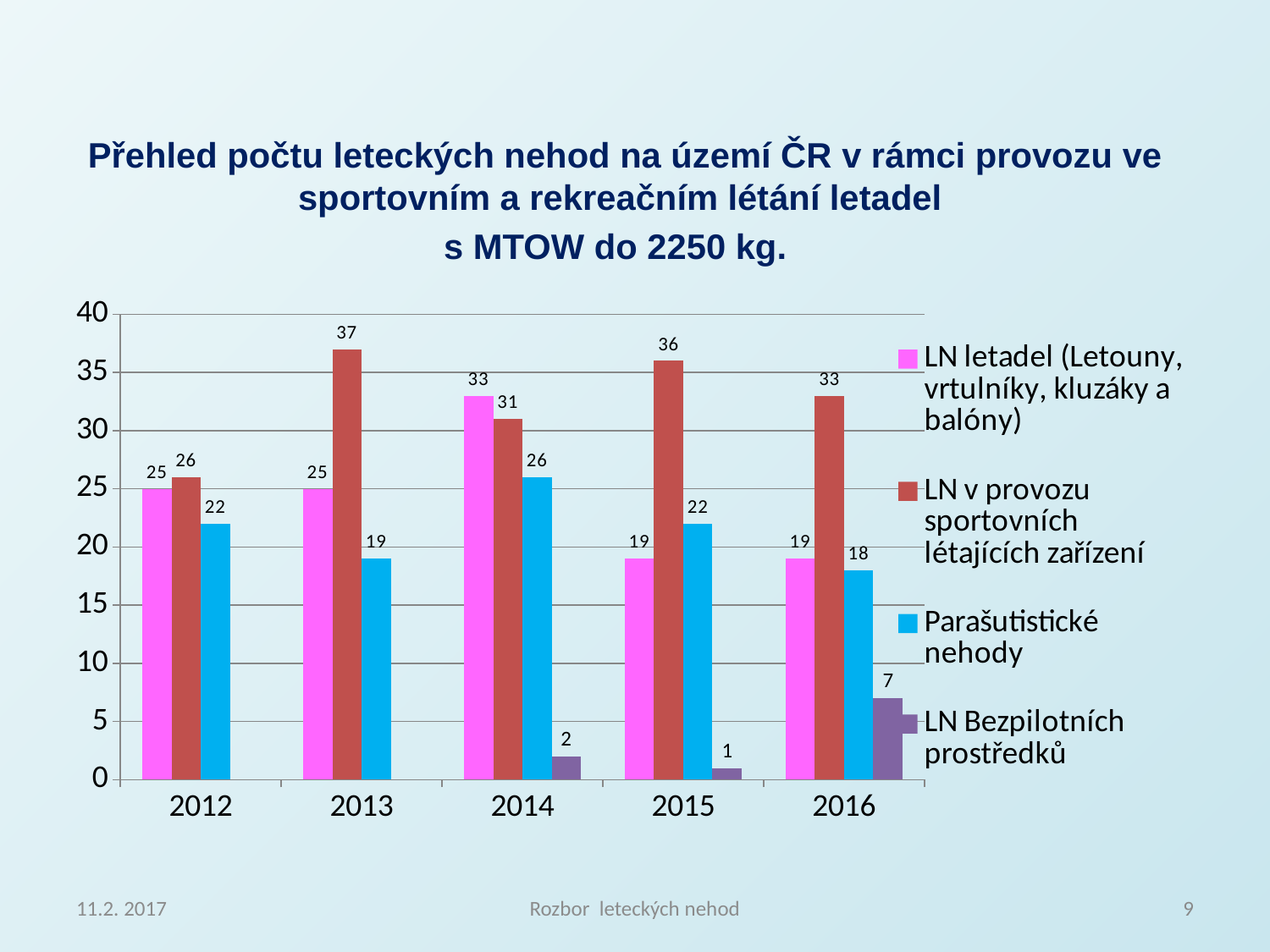
What type of chart is shown on the slide? bar chart In which year is the value for 'Parašutistické nehody' lowest? 2016 What is the value for 'LN v provozu sportovních létajících zařízení' in 2013? 37 In which year is the value for 'LN letadel (Letouny, vrtulníky, kluzáky a balóny)' highest? 2014 Which colour represents 'Parašutistické nehody' in the chart? light blue How many series does the legend list? 4 Does the value for 'LN letadel (Letouny, vrtulníky, kluzáky a balóny)' fall or rise from 2014 to 2015? fall What is the value for 'LN Bezpilotních prostředků' in 2016? 7 What is the value for 'Parašutistické nehody' in 2014? 26 What is the difference between 'LN v provozu sportovních létajících zařízení' and 'LN letadel (Letouny, vrtulníky, kluzáky a balóny)' in 2015? 17 In 2014, which is larger: 'LN letadel (Letouny, vrtulníky, kluzáky a balóny)' or 'LN v provozu sportovních létajících zařízení'? LN letadel (Letouny, vrtulníky, kluzáky a balóny) How many years are shown on the x axis? 5